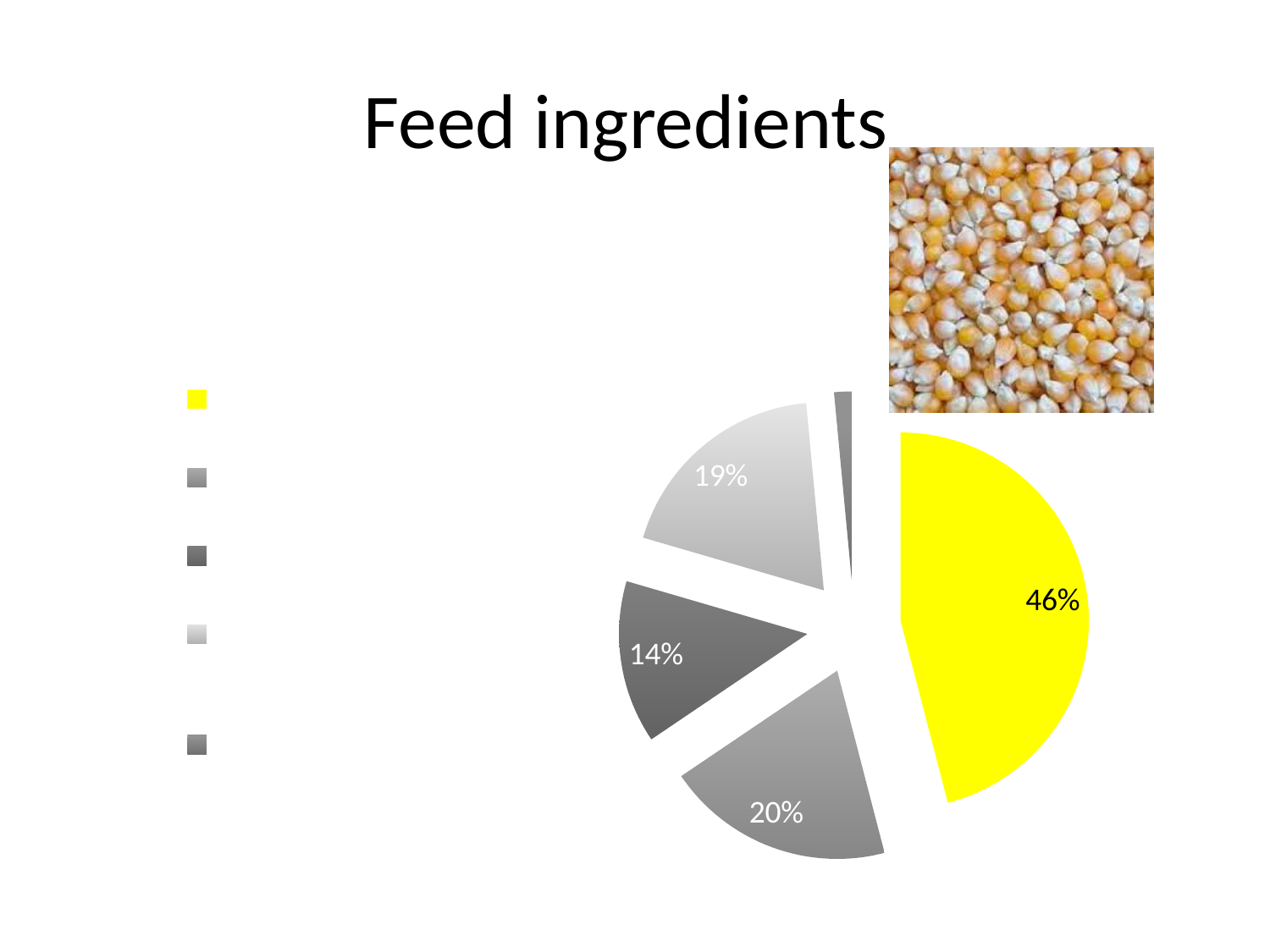
What is the largest percentage shown on the pie chart? 46% What is the title of the slide containing the pie chart? Feed ingredients What is the difference in percentage points between the 46% slice and the 20% slice? 26 percentage points Which is larger, the slice labelled 19% or the slice labelled 14%? 19% How many entries does the legend of the pie chart list? 5 How many slices does the pie chart have? 5 What kind of chart is shown on the slide? Pie chart What is the combined share of the four labelled slices (46%, 20%, 14% and 19%)? 99% What is the difference in percentage points between the 20% slice and the 19% slice? 1 percentage point What percentage is shown on the yellow slice of the pie chart? 46% How many slices of the pie chart have a printed percentage label? 4 What colour is the largest slice of the pie chart? Yellow